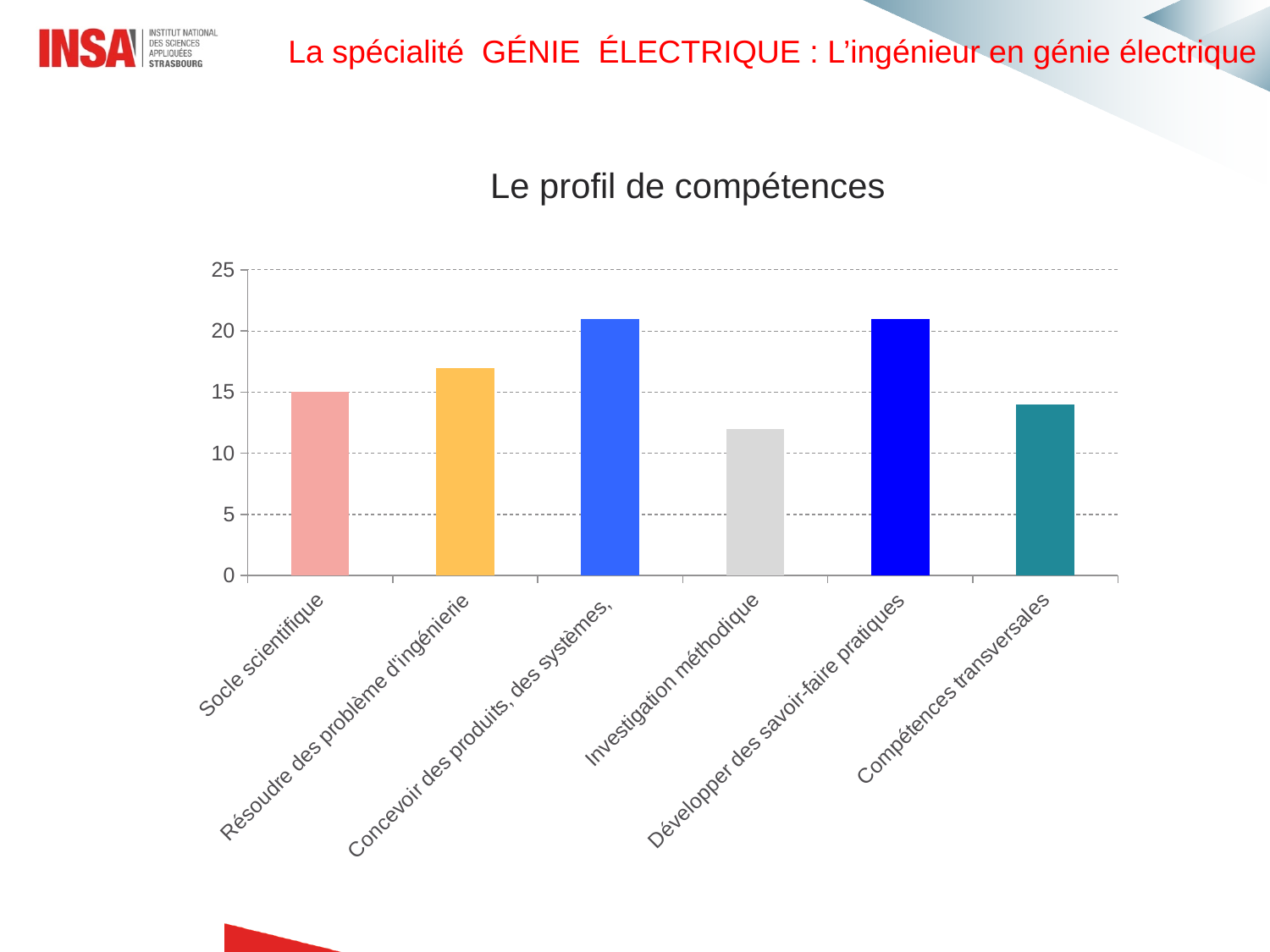
Is the value for Résoudre des problème d'ingénierie greater or less than 15? greater What kind of chart is shown on the slide? bar chart Is the value for Développer des savoir-faire pratiques greater or less than 20? greater Which is larger, the value for Socle scientifique or the value for Résoudre des problème d'ingénierie? Résoudre des problème d'ingénierie What is the value for Socle scientifique? 15 Which is larger, the value for Investigation méthodique or the value for Compétences transversales? Compétences transversales Is the value for Concevoir des produits, des systèmes, greater or less than 20? greater How many categories are plotted in the chart? 6 Which category has the lowest value? Investigation méthodique What is the title of the chart? Le profil de compétences